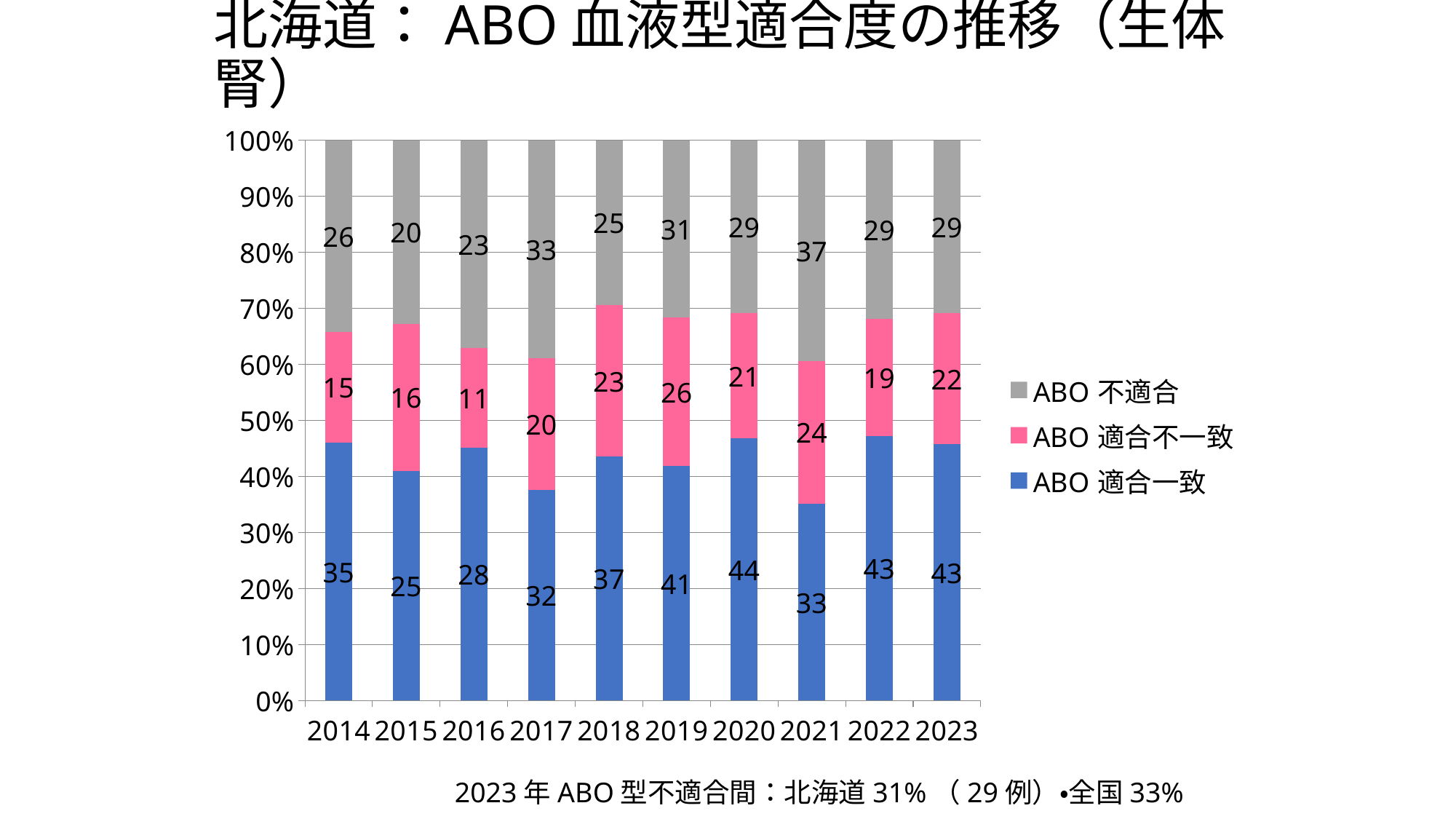
How many series does the legend list? 3 In which year is the ABO 適合不一致 value lowest? 2016 What is the value of ABO 不適合 for 2021? 37 In which year is the ABO 適合一致 value highest? 2020 How many years are shown on the x axis? 10 What is the total of the three labelled values in the 2023 bar? 94 What kind of chart is shown on the slide? Stacked bar chart What is the difference between the ABO 不適合 values for 2021 and 2015? 17 What is the value of ABO 適合一致 for 2020? 44 Which is larger, the ABO 適合一致 value for 2019 or for 2021? 2019 What is the value of ABO 適合不一致 for 2019? 26 Which series is shown in gray in the legend? ABO 不適合